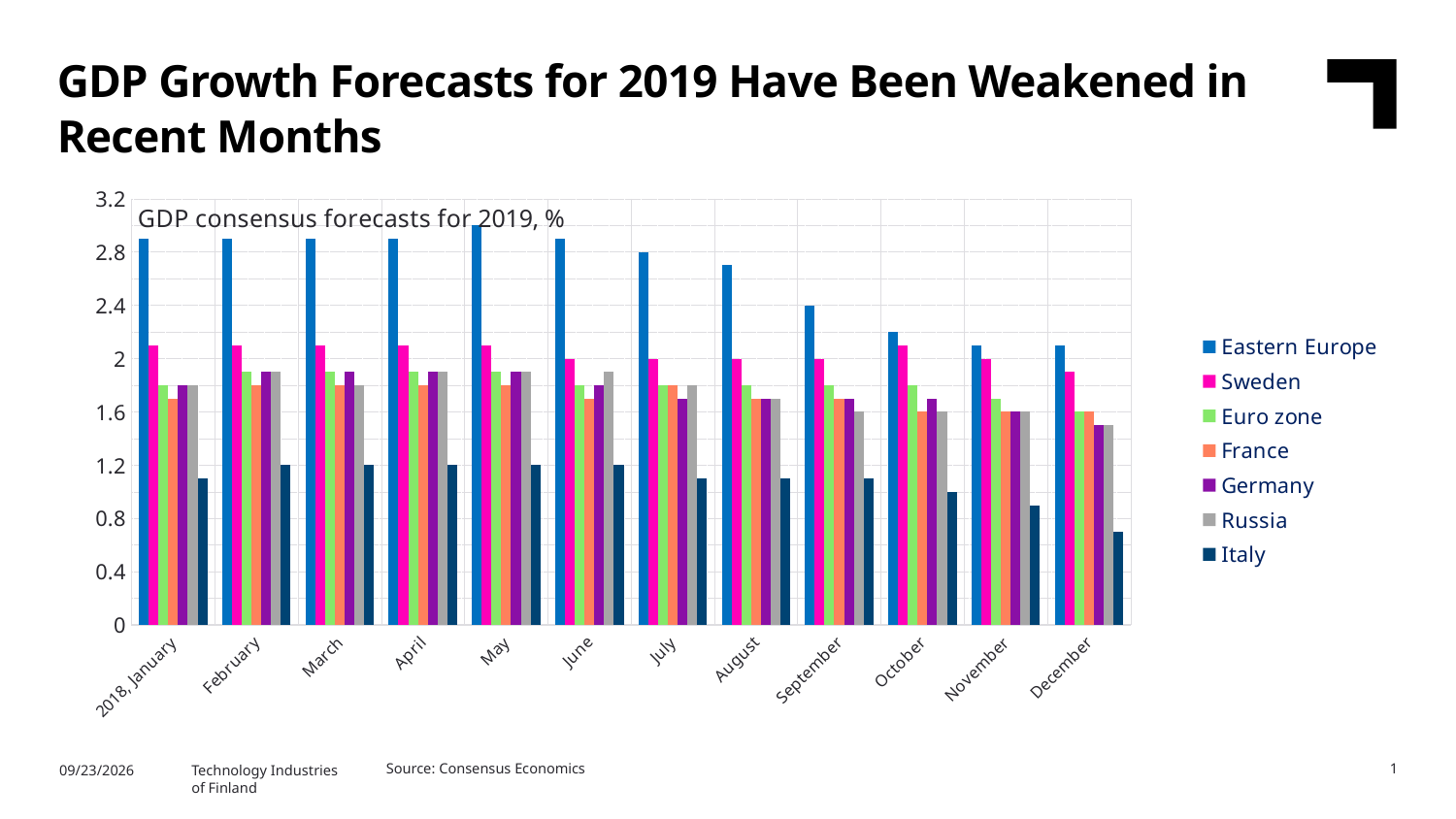
Is the value for Eastern Europe in 2018, January greater or less than 2.8? greater Which is larger in October, the Eastern Europe forecast or the Sweden forecast? Eastern Europe What kind of chart is shown on the slide? Bar chart What is the title printed inside the chart area? GDP consensus forecasts for 2019, % Which is larger in November, the Euro zone forecast or the Italy forecast? Euro zone Is the value for Italy in December greater or less than 0.8? less How many series does the legend list? 7 Does the Eastern Europe forecast rise or fall from May to December? Fall How many months are shown along the x axis? 12 Is the value for Sweden in March greater or less than 2? greater Which series has the lowest forecast in December? Italy Which series has the highest forecast in 2018, January? Eastern Europe